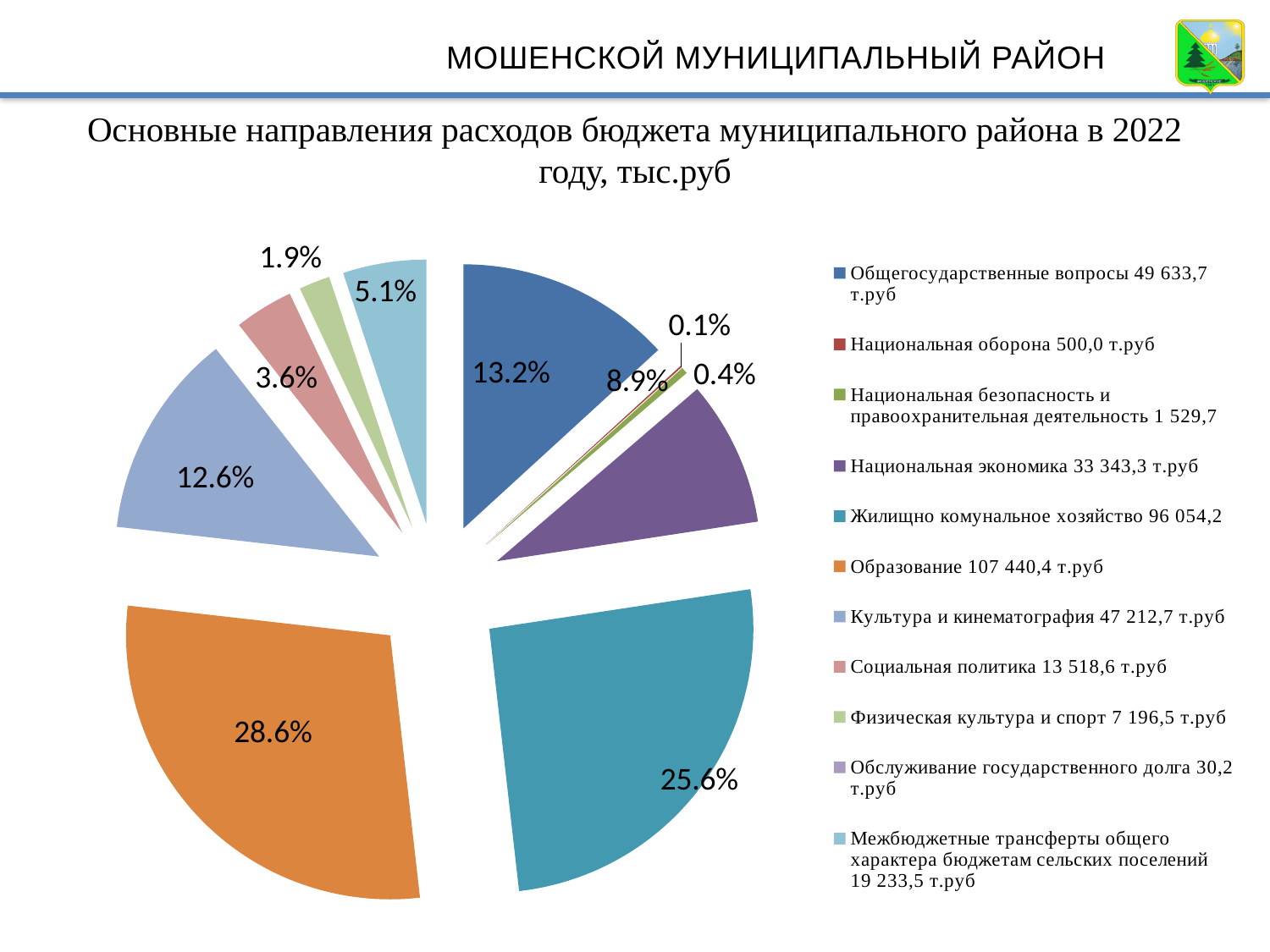
What share of the pie does Образование (education) take? 28.6% Which is larger, the slice for Образование or the slice for Жилищно коммунальное хозяйство? Образование What share of the pie does Культура и кинематография take? 12.6% What is the value for Национальная экономика shown in the legend? 33 343,3 т.руб What share of the pie does Общегосударственные вопросы take? 13.2% Which category has the largest slice of the pie? Образование What is the value for Социальная политика shown in the legend? 13 518,6 т.руб What kind of chart is shown on the slide? pie chart How many entries does the legend of the pie chart list? 11 What is the title of the chart on the slide? Основные направления расходов бюджета муниципального района в 2022 году, тыс.руб What is the difference in percentage points between the Образование slice (28.6%) and the Жилищно коммунальное хозяйство slice (25.6%)? 3.0%